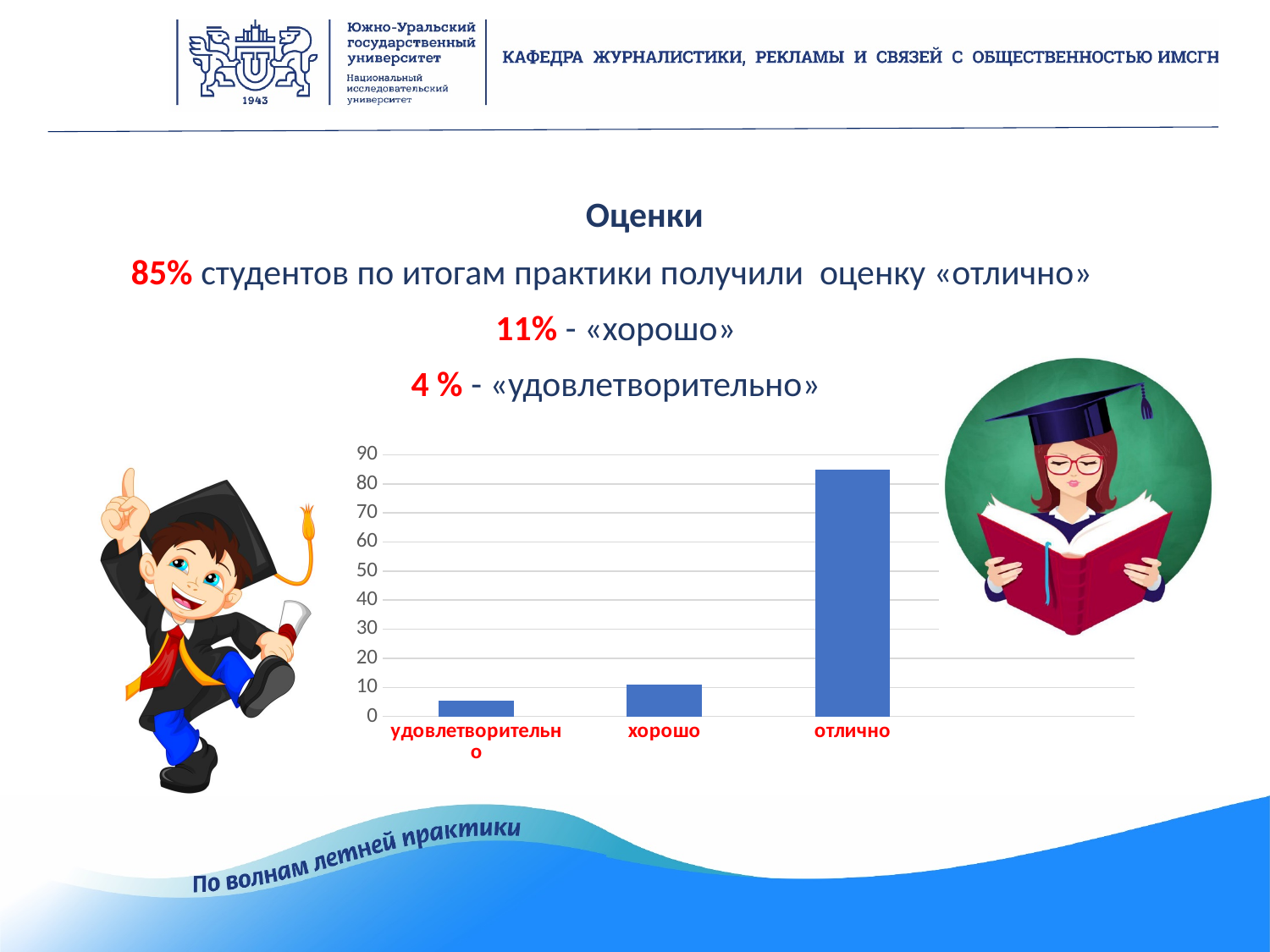
What colour are the bars in the chart? blue What is the highest value shown on the vertical axis of the chart? 90 Which category has the lowest bar in the chart? удовлетворительно What kind of chart is shown on the slide? bar chart Is the value for отлично greater or less than 90? less Do the bar values rise or fall from left to right along the x axis? rise Which is larger, the bar for хорошо or the bar for удовлетворительно? хорошо Which category has the highest bar in the chart? отлично How many categories are shown on the x axis of the chart? 3 Is the value for хорошо greater or less than 20? less Is the value for отлично greater or less than 80? greater